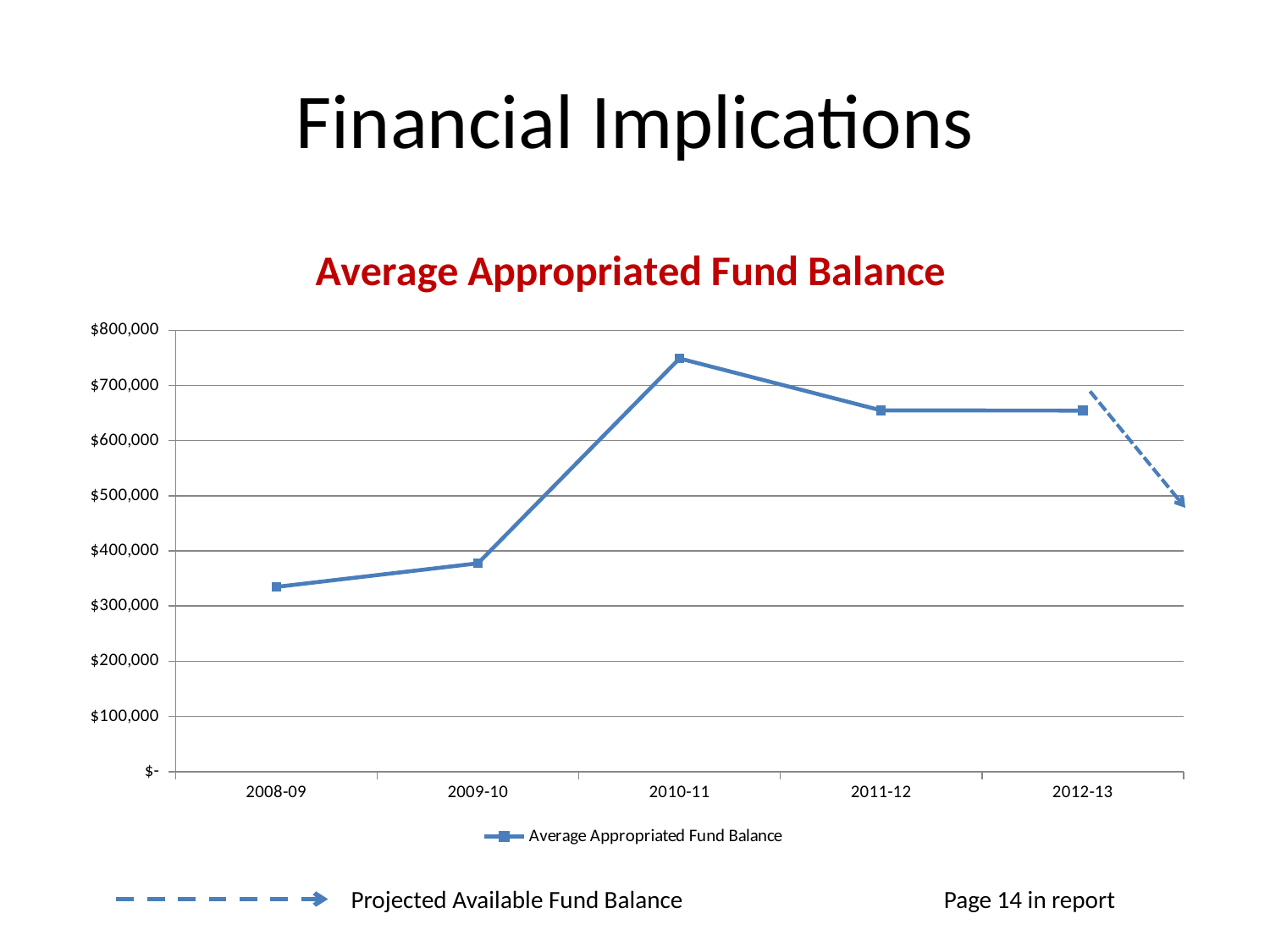
Which fiscal year has the lowest Average Appropriated Fund Balance? 2008-09 What kind of chart is shown on the slide? Line chart Is the Average Appropriated Fund Balance for 2010-11 greater or less than $700,000? greater Which is larger, the Average Appropriated Fund Balance for 2010-11 or for 2009-10? 2010-11 Which fiscal year has the highest Average Appropriated Fund Balance? 2010-11 How many fiscal years are labelled on the x axis of the chart? 5 Is the Average Appropriated Fund Balance for 2008-09 greater or less than $400,000? less What does the dashed arrow line at the right of the chart represent, according to the slide? Projected Available Fund Balance What is the title of the chart? Average Appropriated Fund Balance Is the Average Appropriated Fund Balance for 2011-12 greater or less than $600,000? greater How many series does the chart's legend list? 1 Does the Average Appropriated Fund Balance rise or fall from 2008-09 to 2010-11? rise